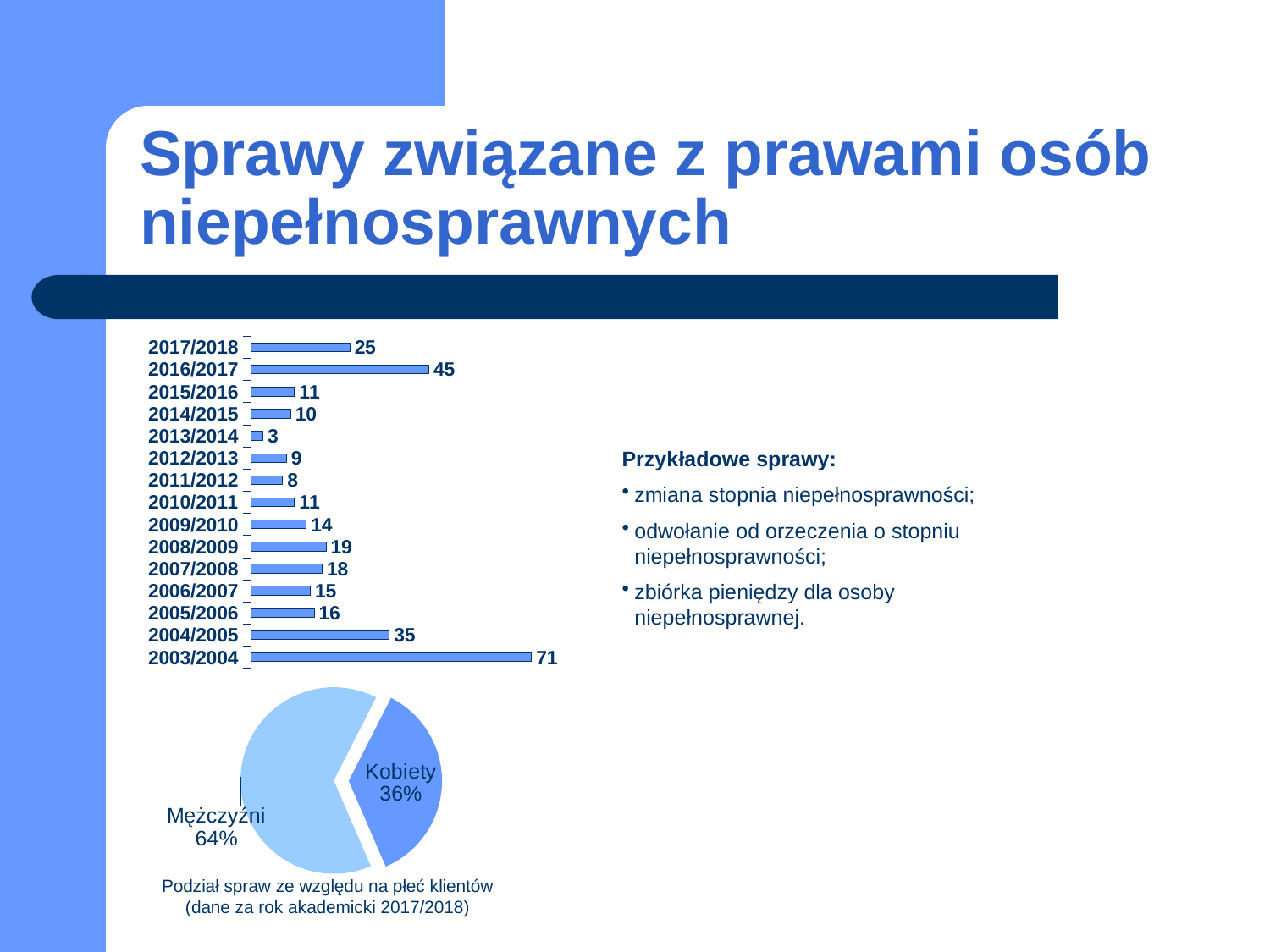
In the bar chart, what is the value for 2017/2018? 25 In the bar chart, which academic year has the highest value? 2003/2004 In the pie chart, what share is labelled Kobiety? 36% In the bar chart, how many academic years are shown? 15 In the bar chart, which academic year has the lowest value? 2013/2014 In the pie chart, which slice is larger: Mężczyźni or Kobiety? Mężczyźni In the bar chart, what is the value for 2013/2014? 3 What kind of chart is the lower chart on the slide? pie chart In the bar chart, which is larger: the value for 2008/2009 or the value for 2007/2008? 2008/2009 In the bar chart, what is the difference between the values for 2003/2004 and 2004/2005? 36 What kind of chart is the upper chart on the slide? bar chart In the bar chart, what is the value for 2016/2017? 45